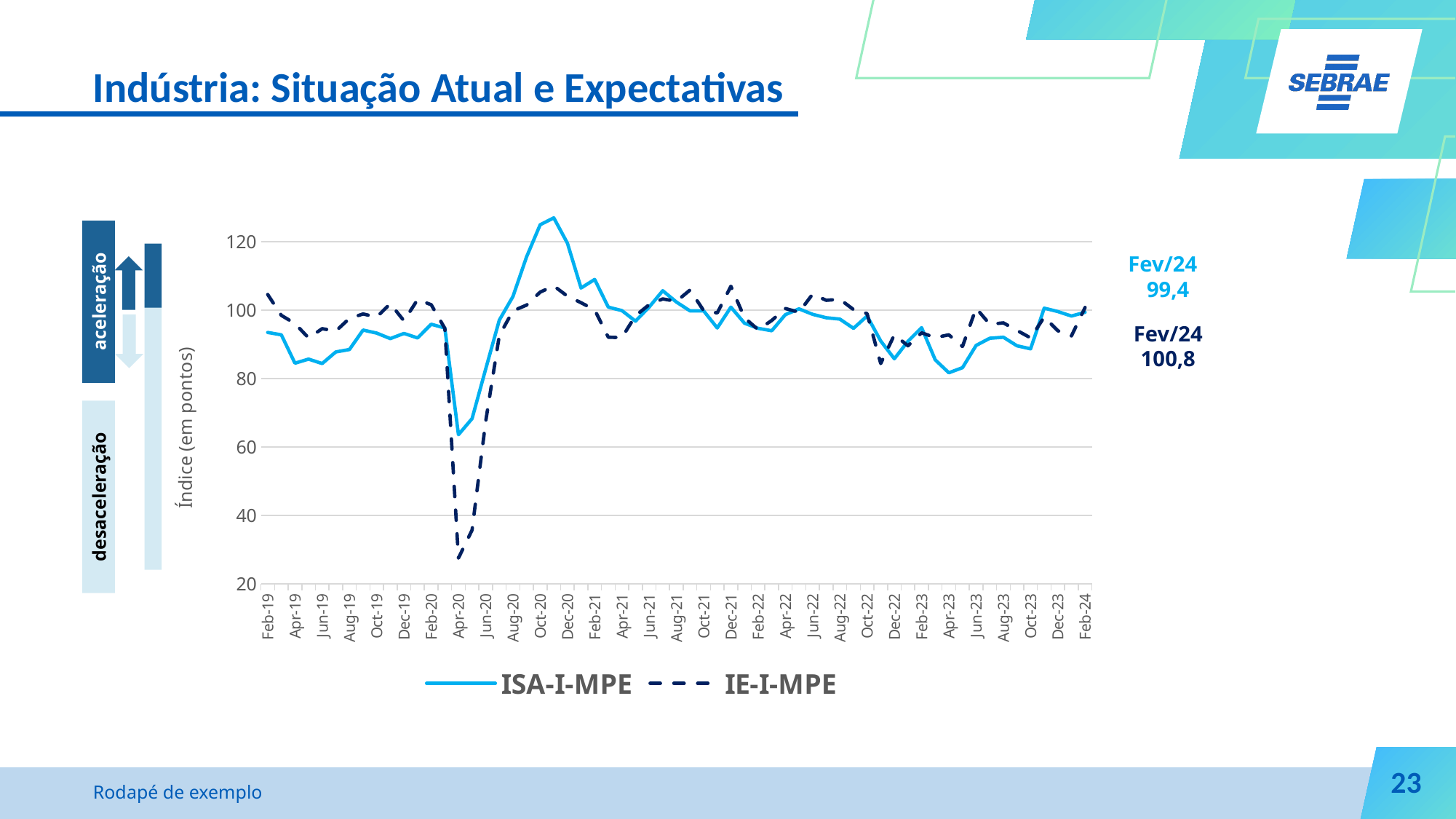
Which series reaches the highest point on the chart? ISA-I-MPE Is the value of ISA-I-MPE at Oct-20 greater or less than 120? greater What is the value of ISA-I-MPE for Fev/24? 99,4 How many series does the legend list? 2 What is the label of the vertical axis? Índice (em pontos) Which series reaches the lowest point on the chart? IE-I-MPE Which series has the higher value in Fev/24, ISA-I-MPE or IE-I-MPE? IE-I-MPE What is the difference between the IE-I-MPE and ISA-I-MPE values in Fev/24? 1,4 Is the value of ISA-I-MPE at Apr-20 greater or less than 80? less What is the value of IE-I-MPE for Fev/24? 100,8 Is the value of IE-I-MPE at Apr-20 greater or less than 40? less What type of chart is shown on the slide? line chart